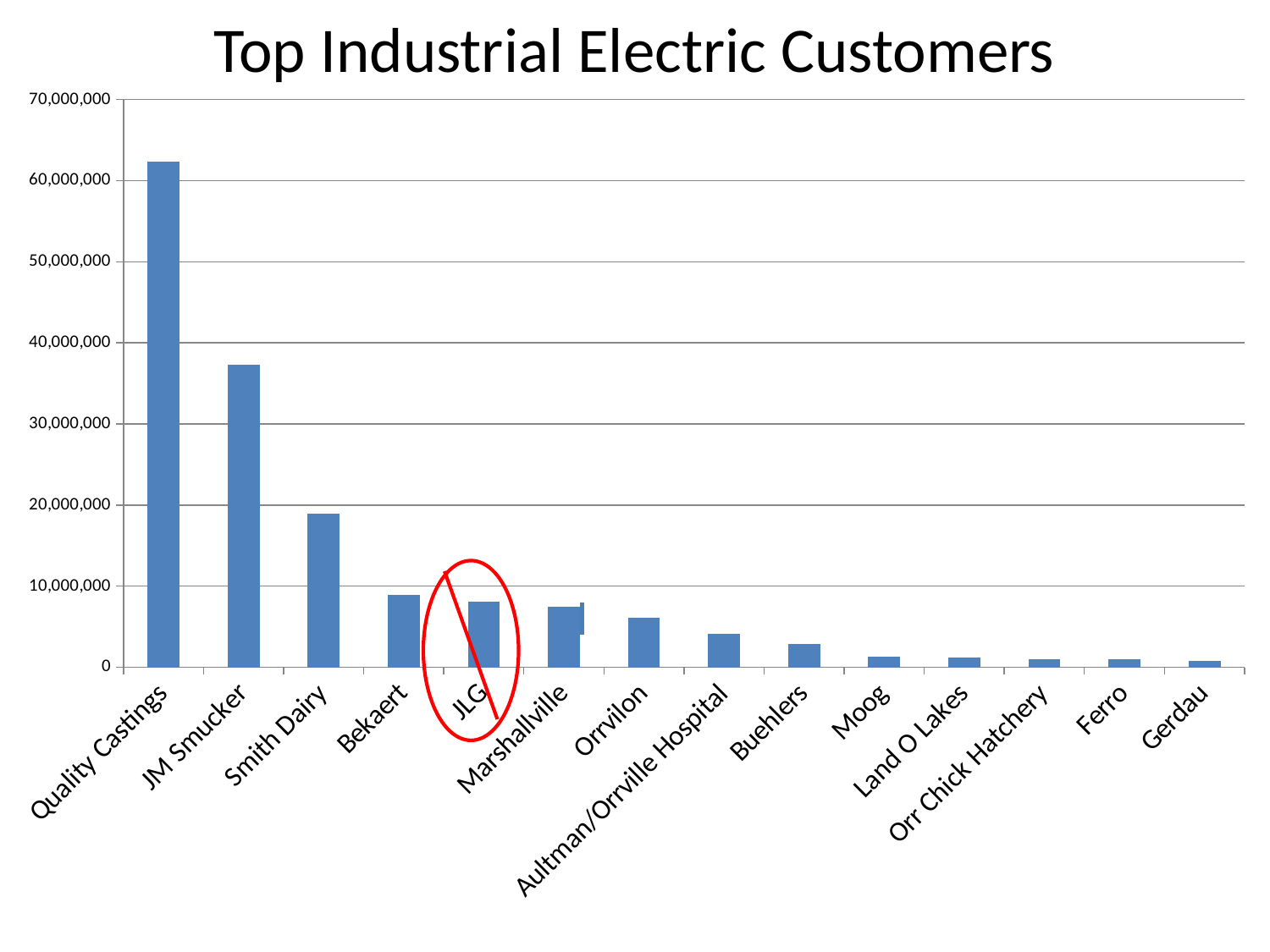
Is the value for JM Smucker greater or less than 40,000,000? less How many customers are shown on the x axis of the chart? 14 Which has a larger value, Bekaert or Orrvilon? Bekaert Is the value for Quality Castings greater or less than 60,000,000? greater Is the value for Smith Dairy greater or less than 20,000,000? less What kind of chart is shown on the slide? bar chart Do the values generally rise or fall moving from left to right along the x axis? fall Which has a larger value, JM Smucker or Smith Dairy? JM Smucker Which customer's label is circled in red on the chart? JLG What is the title of the chart? Top Industrial Electric Customers Which customer has the highest value in the chart? Quality Castings